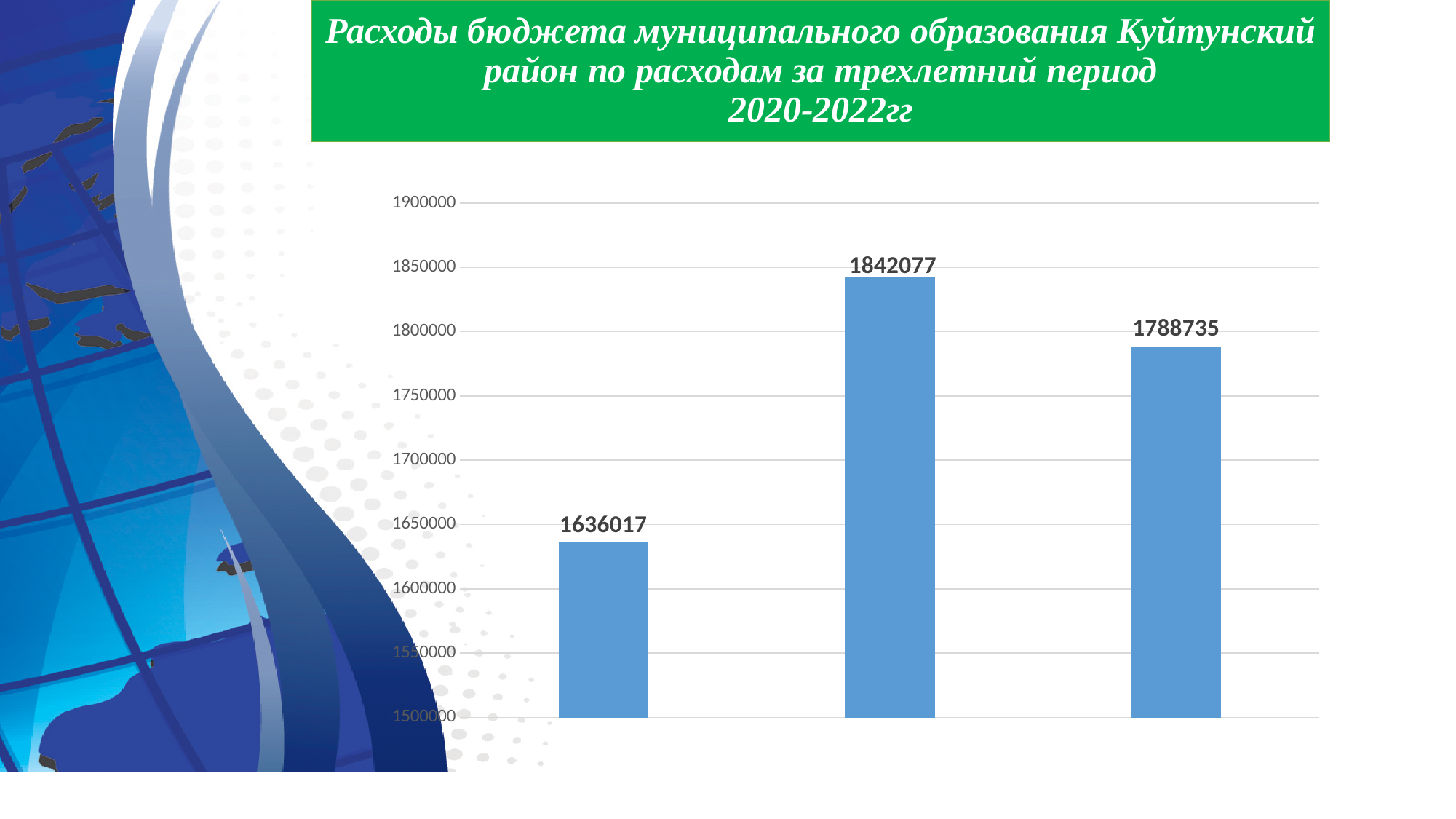
Which bar has the highest value: the first, second or third? the second (middle) bar What is the value shown on the middle bar? 1842077 Is the value of the leftmost bar greater or less than 1650000? less What is the difference between the middle bar's value and the leftmost bar's value? 206060 Which bar has the lowest value: the first, second or third? the first (leftmost) bar What period does the chart title say the budget expenditures cover? 2020-2022 What is the value shown on the first (leftmost) bar? 1636017 What is the difference between the middle bar's value and the rightmost bar's value? 53342 Which is larger, the value of the rightmost bar or the value of the leftmost bar? the rightmost bar How many bars are plotted in the chart? 3 What type of chart is shown on the slide? bar chart What is the value shown on the third (rightmost) bar? 1788735